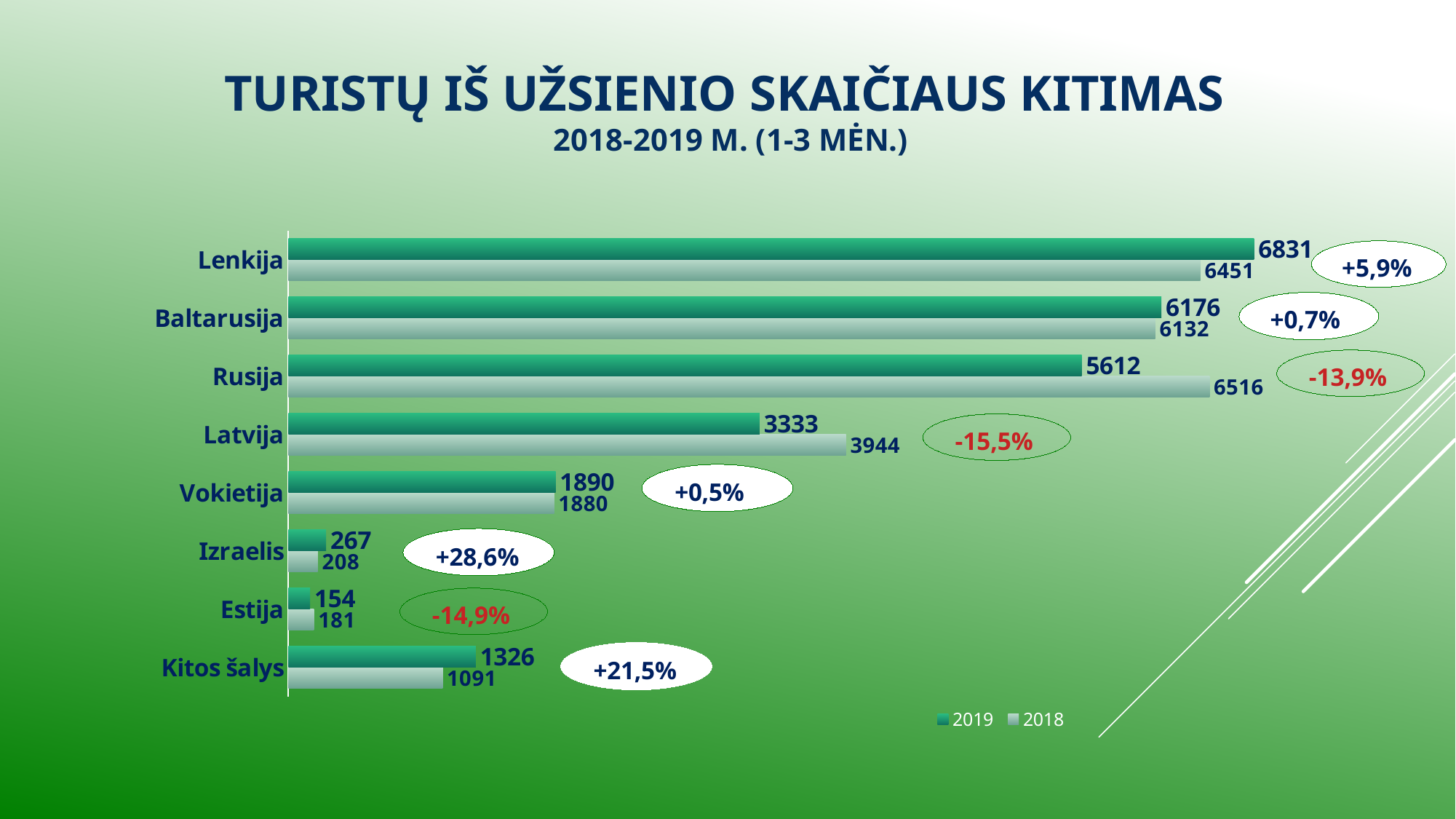
What is the 2019 value for Kitos šalys? 1326 What is the 2019 value for Lenkija? 6831 What kind of chart is shown on the slide? bar chart How many categories are shown on the chart? 8 How many series does the legend list? 2 Which category has the highest 2019 value? Lenkija What percentage change is shown next to Izraelis? +28,6% What is the difference between the 2018 and 2019 values for Latvija? 611 What is the 2018 value for Rusija? 6516 What is the difference between the 2019 and 2018 values for Vokietija? 10 Which is larger for Rusija, the 2019 value or the 2018 value? 2018 Which category has the lowest 2018 value? Estija